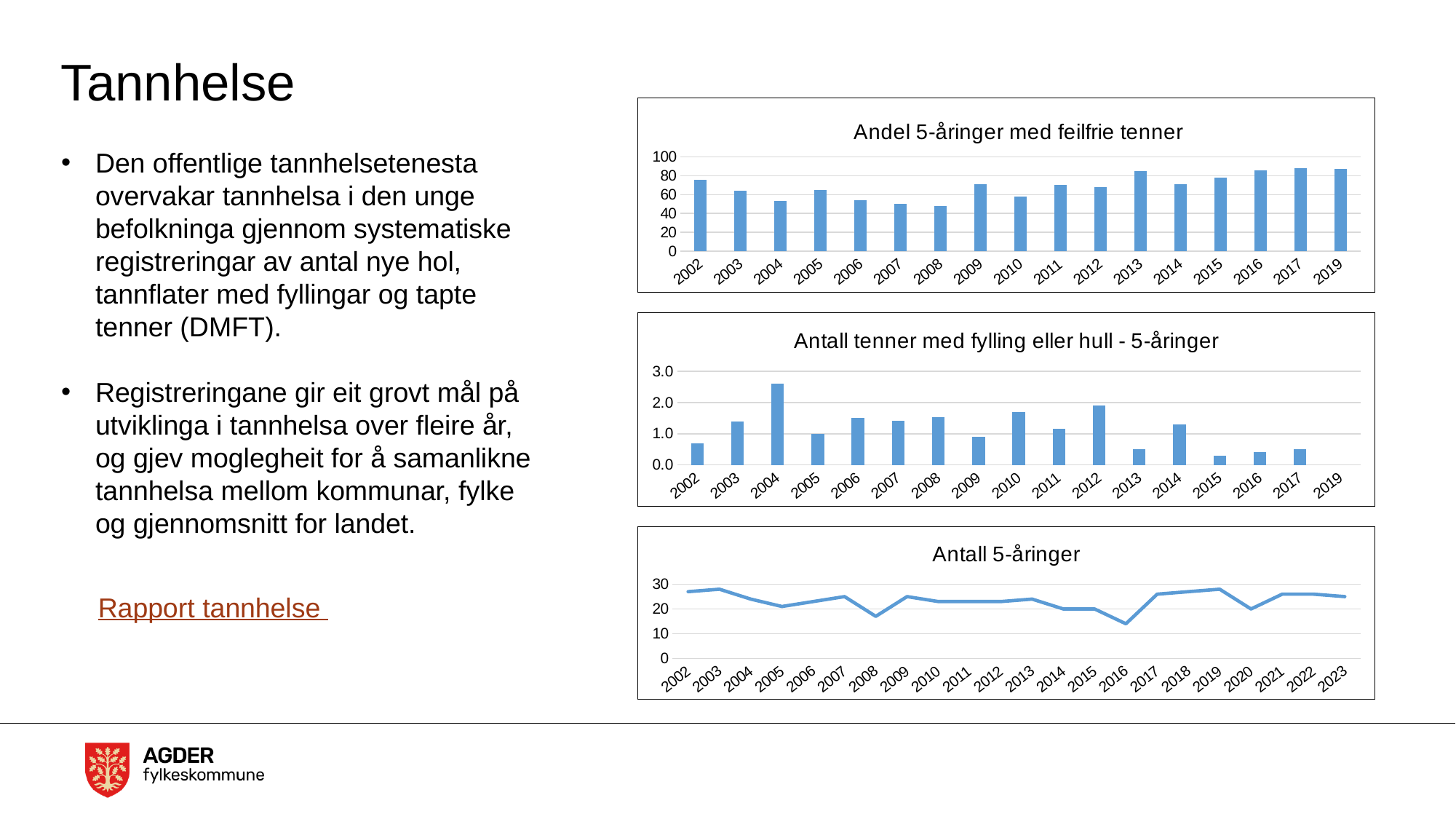
In the middle chart 'Antall tenner med fylling eller hull - 5-åringer', which year has the highest value? 2004 What kind of chart is the bottom chart, 'Antall 5-åringer'? line chart In the top chart 'Andel 5-åringer med feilfrie tenner', is the value for 2002 greater or less than 60? greater In the middle chart 'Antall tenner med fylling eller hull - 5-åringer', is the value for 2004 greater or less than 2.0? greater In the bottom chart 'Antall 5-åringer', how many years are shown on the x axis? 22 In the bottom chart 'Antall 5-åringer', which year has the lowest value? 2016 In the top chart 'Andel 5-åringer med feilfrie tenner', which is larger, the value for 2013 or the value for 2010? 2013 In the middle chart 'Antall tenner med fylling eller hull - 5-åringer', is the value for 2015 greater or less than 1.0? less In the top chart 'Andel 5-åringer med feilfrie tenner', how many years are shown on the x axis? 17 What kind of chart is the top chart, 'Andel 5-åringer med feilfrie tenner'? bar chart